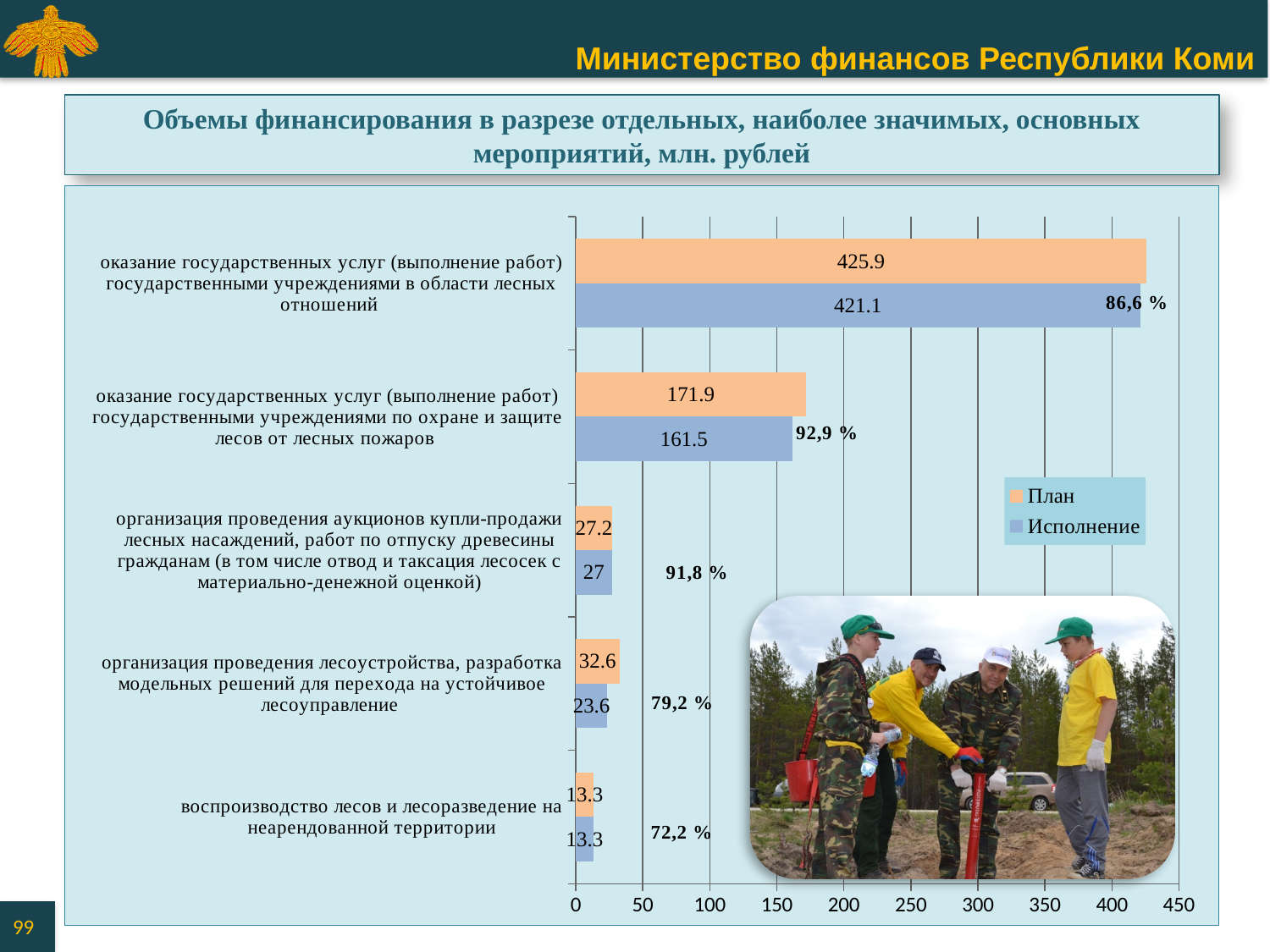
What is the План value for "организация проведения лесоустройства, разработка модельных решений для перехода на устойчивое лесоуправление"? 32.6 Which category has the lowest План value? воспроизводство лесов и лесоразведение на неарендованной территории What is the Исполнение value for "оказание государственных услуг (выполнение работ) государственными учреждениями по охране и защите лесов от лесных пожаров"? 161.5 How many categories are shown on the chart? 5 What are the two series named in the legend? План and Исполнение What is the План value for "оказание государственных услуг (выполнение работ) государственными учреждениями в области лесных отношений"? 425.9 What percentage is printed next to the bars for "воспроизводство лесов и лесоразведение на неарендованной территории"? 72,2 % How many series does the legend list? 2 Which is larger for "организация проведения лесоустройства, разработка модельных решений для перехода на устойчивое лесоуправление": the План value or the Исполнение value? План Which category has the highest Исполнение value? оказание государственных услуг (выполнение работ) государственными учреждениями в области лесных отношений What kind of chart is shown on the slide? bar chart What is the difference between the План and Исполнение values for "оказание государственных услуг (выполнение работ) государственными учреждениями по охране и защите лесов от лесных пожаров"? 10.4